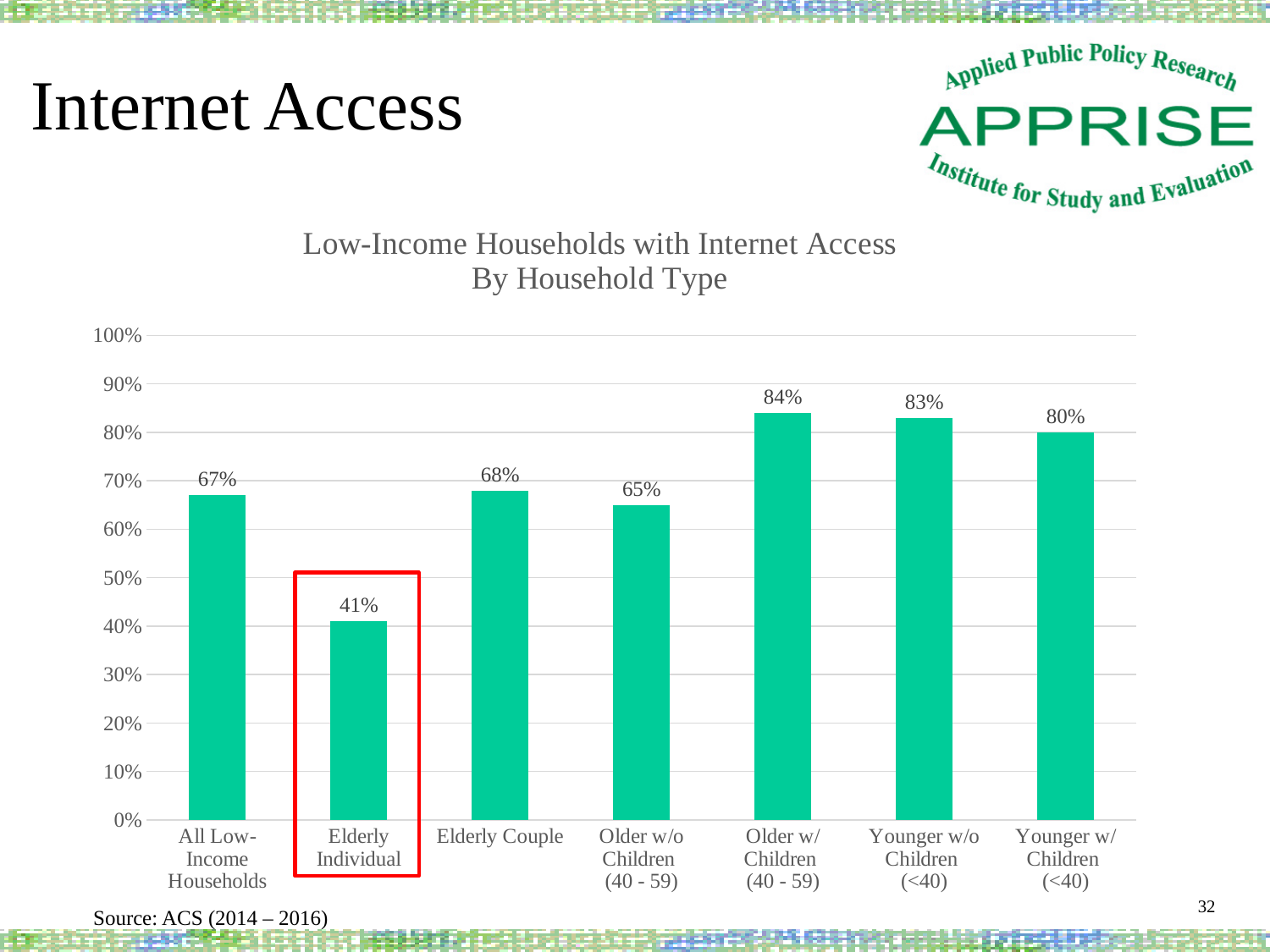
What is the value for Older w/ Children (40 - 59)? 84% What is the value for All Low-Income Households? 67% Which household type has the highest share with internet access? Older w/ Children (40 - 59) What is the difference between Elderly Couple and Elderly Individual? 27% What kind of chart is shown on the slide? bar chart Is the value for Elderly Individual greater or less than 50%? less How many household types are shown in the chart? 7 Which is larger, the value for Elderly Couple or the value for Older w/o Children (40 - 59)? Elderly Couple What is the difference between Younger w/o Children (<40) and Younger w/ Children (<40)? 3% What percentage of Elderly Individual low-income households have internet access? 41% Which bar is outlined with a red box? Elderly Individual Which household type has the lowest share with internet access? Elderly Individual